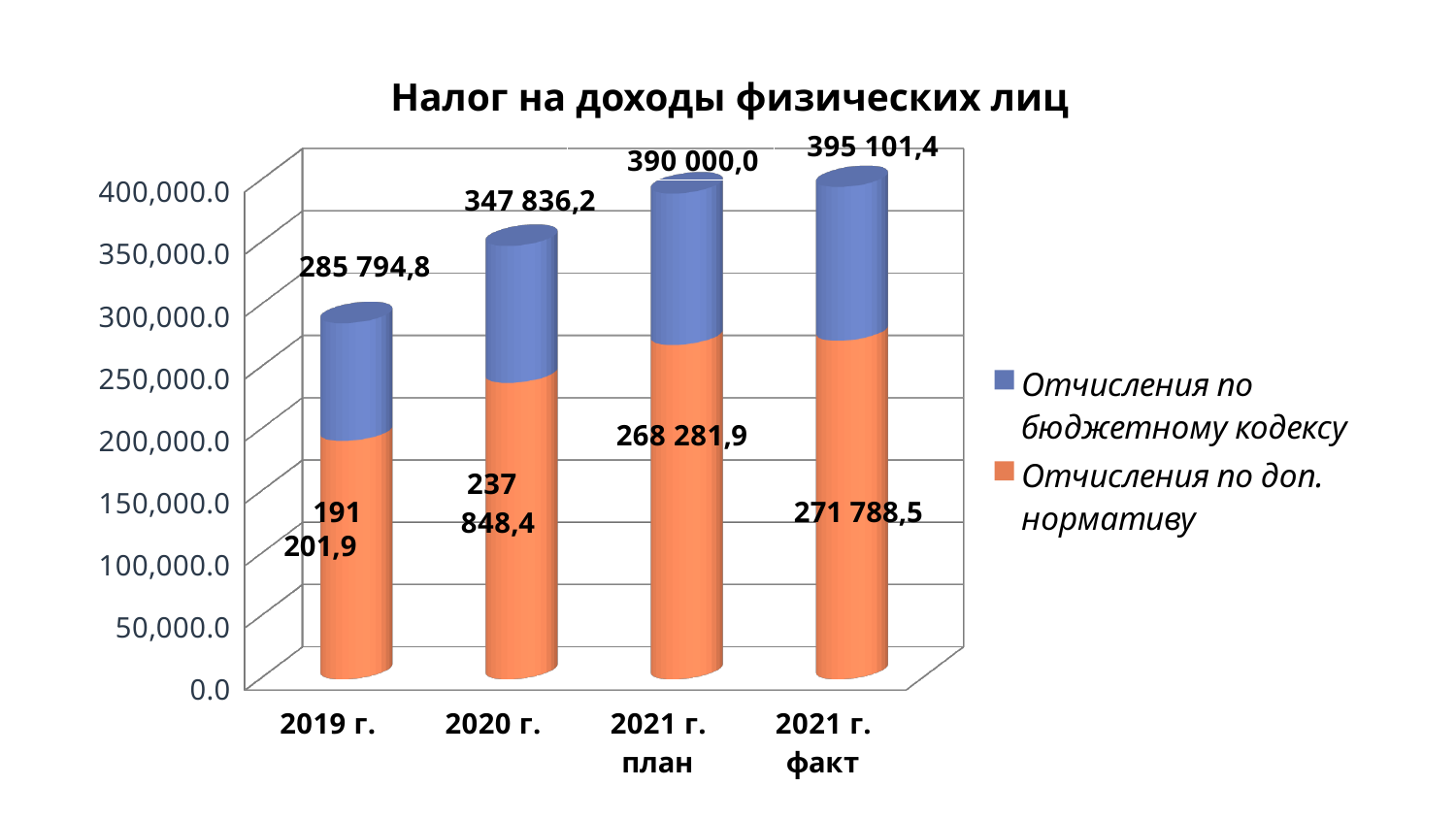
What is the value of 'Отчисления по доп. нормативу' for 2021 г. план? 268 281,9 Which category has the highest value for 'Отчисления по доп. нормативу'? 2021 г. факт What is the total of the stacked bar for 2021 г. факт? 395 101,4 Do the bar totals rise or fall from 2019 г. to 2021 г. факт? rise Which category has the lowest total? 2019 г. How many categories are shown on the x axis? 4 What is the value of 'Отчисления по доп. нормативу' for 2019 г.? 191 201,9 How many series does the legend list? 2 What is the total of the stacked bar for 2020 г.? 347 836,2 What is the title of the chart? Налог на доходы физических лиц What is the difference between the 'Отчисления по доп. нормативу' values for 2020 г. and 2019 г.? 46 646,5 What type of chart is shown on the slide? stacked bar chart